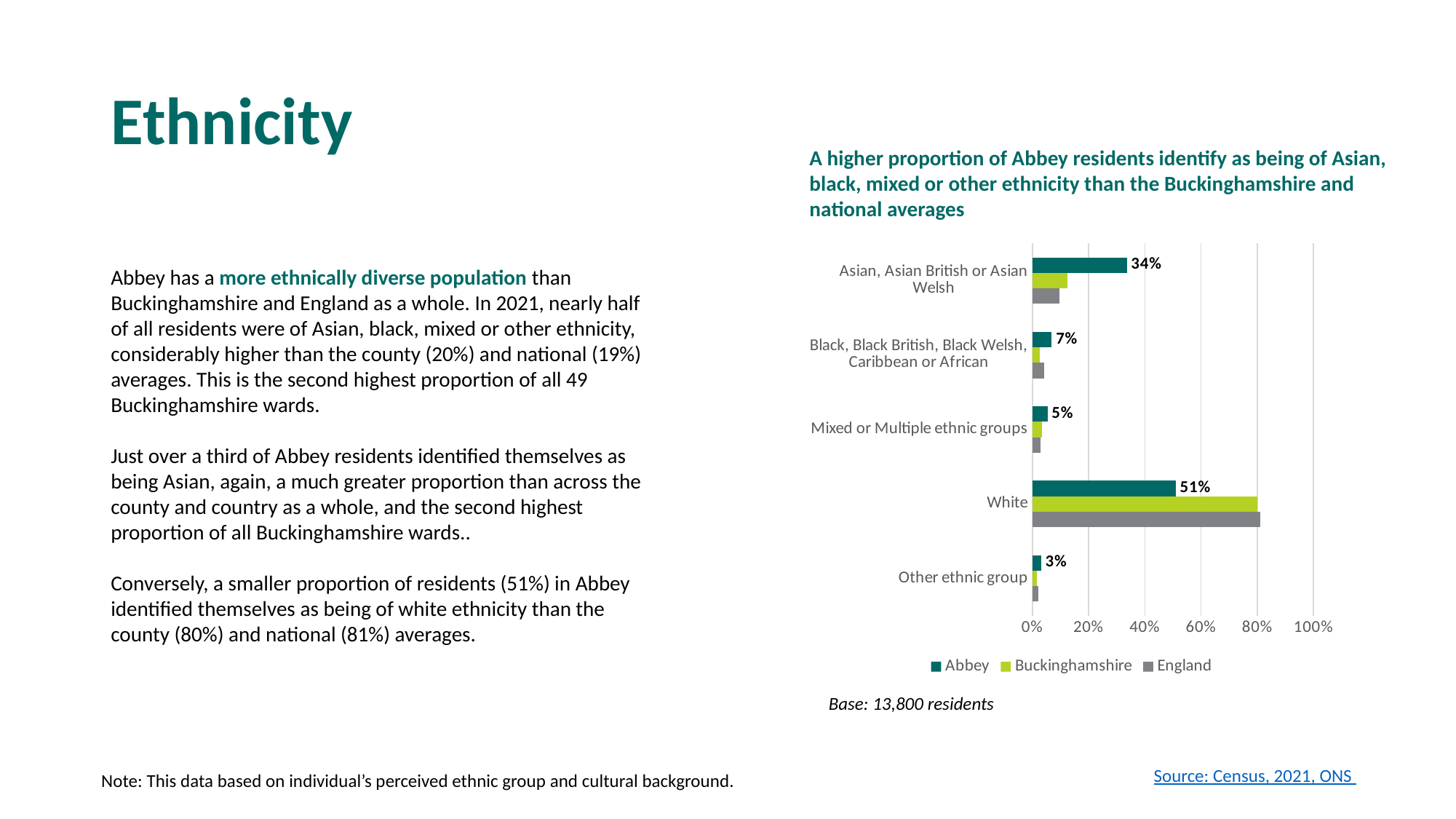
What is the Abbey value for Mixed or Multiple ethnic groups? 5% What percentage of Abbey residents identify as Asian, Asian British or Asian Welsh? 34% Which ethnic group has the lowest value for Abbey? Other ethnic group How many series does the chart's legend list? 3 What is the difference between the Abbey values for White and for Asian, Asian British or Asian Welsh? 17% What is the Abbey value for Other ethnic group? 3% Which ethnic group has the highest value for Abbey? White How many ethnic group categories are shown on the chart? 5 In the Asian, Asian British or Asian Welsh category, which is larger: the Abbey value or the Buckinghamshire value? Abbey What is the value for Abbey in the White category? 51% What is the Abbey value for Black, Black British, Black Welsh, Caribbean or African? 7% Is the Buckinghamshire value for White greater or less than 60%? greater